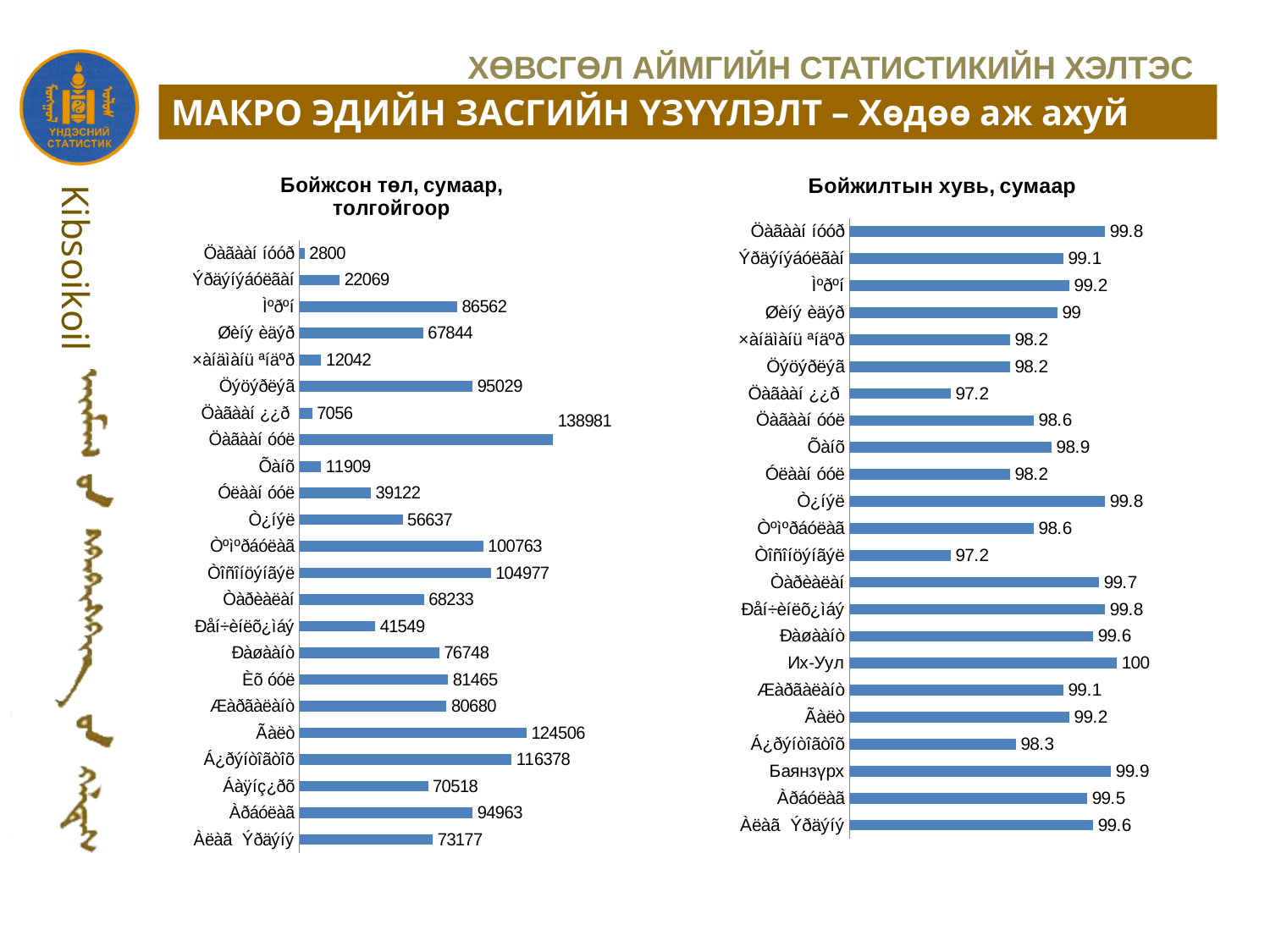
In the right chart 'Бойжилтын хувь, сумаар', what is the value for Их-Уул? 100 How many categories are plotted in the left chart 'Бойжсон төл, сумаар, толгойгоор'? 23 In the right chart 'Бойжилтын хувь, сумаар', what is the difference between the values for Их-Уул and Баянзурх? 0.1 What is the title of the chart on the right side of the slide? Бойжилтын хувь, сумаар In the right chart 'Бойжилтын хувь, сумаар', which category has the highest value? Их-Уул In the left chart 'Бойжсон төл, сумаар, толгойгоор', what is the largest value shown on any bar? 138981 What is the title of the chart on the left side of the slide? Бойжсон төл, сумаар, толгойгоор In the right chart 'Бойжилтын хувь, сумаар', what is the value for Баянзурх? 99.9 What kind of chart is the left chart titled 'Бойжсон төл, сумаар, толгойгоор'? bar chart In the right chart 'Бойжилтын хувь, сумаар', which is larger, the value for Их-Уул or for Баянзурх? Их-Уул In the left chart 'Бойжсон төл, сумаар, толгойгоор', what is the smallest value shown on any bar? 2800 How many categories are plotted in the right chart 'Бойжилтын хувь, сумаар'? 23